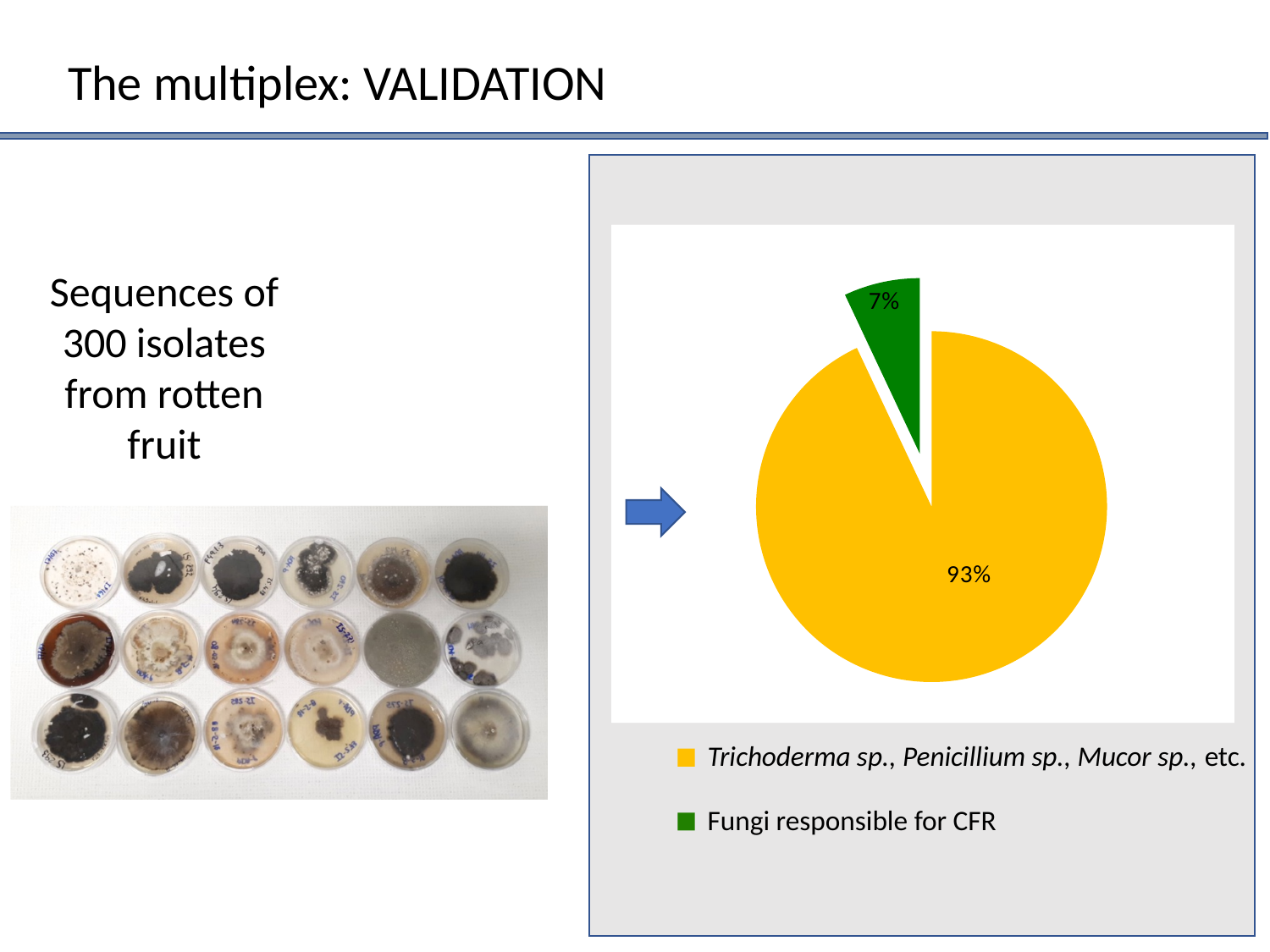
Which slice of the pie is the smallest? Fungi responsible for CFR Which slice of the pie is the largest? Trichoderma sp., Penicillium sp., Mucor sp., etc. Which is larger: the slice for "Fungi responsible for CFR" or the slice for "Trichoderma sp., Penicillium sp., Mucor sp., etc."? Trichoderma sp., Penicillium sp., Mucor sp., etc. What colour is the slice for "Trichoderma sp., Penicillium sp., Mucor sp., etc."? yellow What is the difference in percentage points between the two slices of the pie? 86 What kind of chart is shown on the slide? pie chart What share of the pie is labelled "Trichoderma sp., Penicillium sp., Mucor sp., etc."? 93% What share of the pie is labelled "Fungi responsible for CFR"? 7% How many slices does the pie chart have? 2 What colour is the slice for "Fungi responsible for CFR"? green How many entries does the legend list? 2